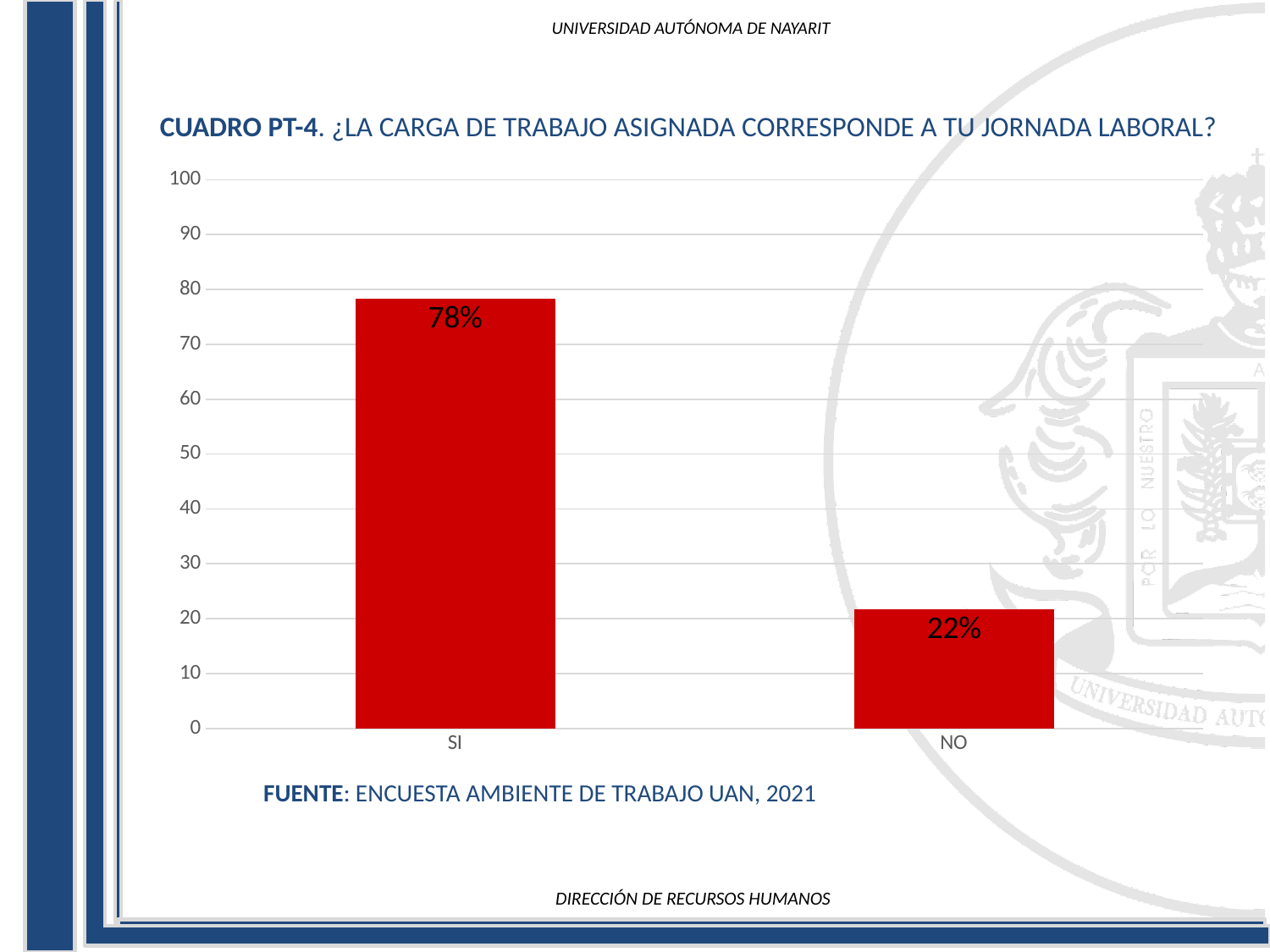
Is the value for NO greater or less than 30? less What source is cited below the chart? ENCUESTA AMBIENTE DE TRABAJO UAN, 2021 Which category has the lowest value? NO Which category has the highest value? SI What is the total of the two bar values? 100% Which is larger, the value for SI or the value for NO? SI How many categories are shown on the x axis? 2 Is the value for SI greater or less than 70? greater What is the difference between the values for SI and NO? 56% What is the value for SI? 78% What kind of chart is shown on the slide? bar chart What is the value for NO? 22%